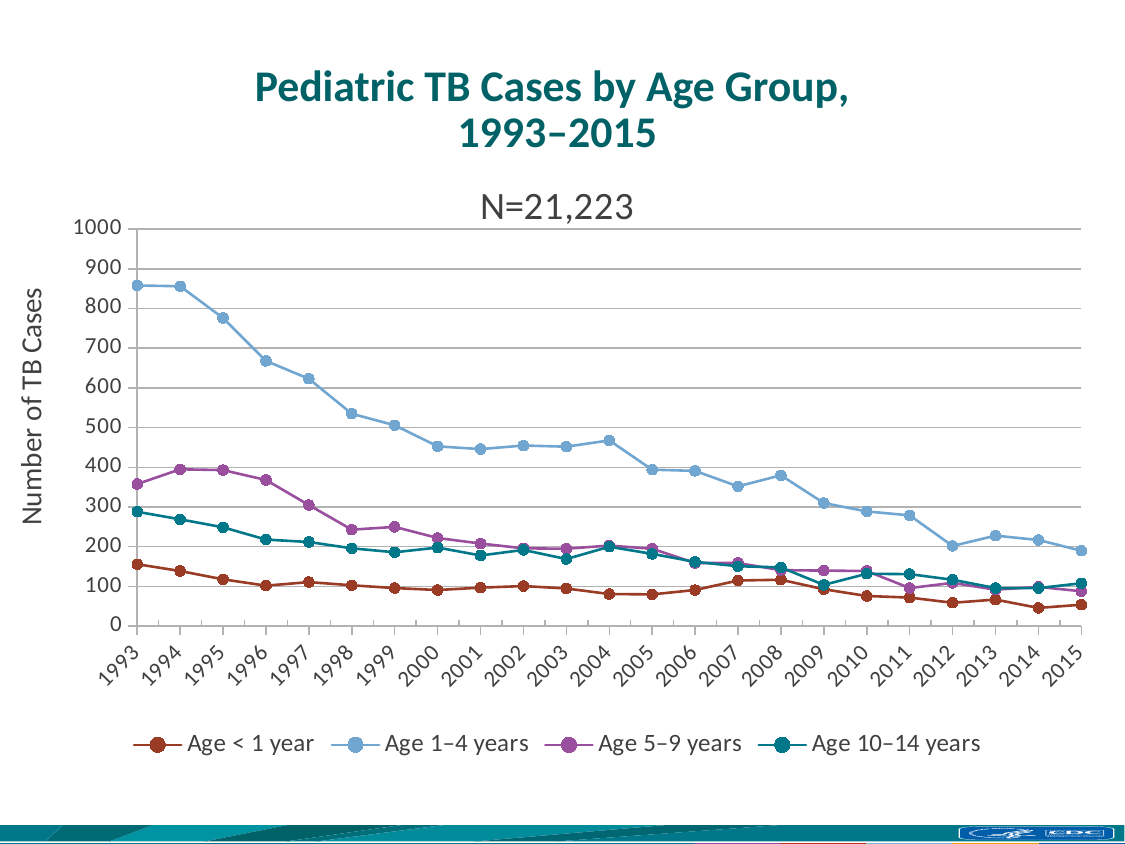
How many series does the legend list? 4 Is the value for Age 5–9 years in 1995 greater or less than 300? greater Which age group had the highest number of TB cases in 1993? Age 1–4 years What total N is shown above the chart? N=21,223 Is the value for Age 1–4 years in 1993 greater or less than 800? greater In 1995, which had more TB cases: Age 5–9 years or Age 10–14 years? Age 5–9 years How many years are plotted along the x axis? 23 Which age group had the lowest number of TB cases in 1993? Age < 1 year What kind of chart is shown on the slide? line chart Is the value for Age < 1 year in 2014 greater or less than 100? less Do the values for Age 1–4 years generally rise or fall from 1993 to 2015? fall